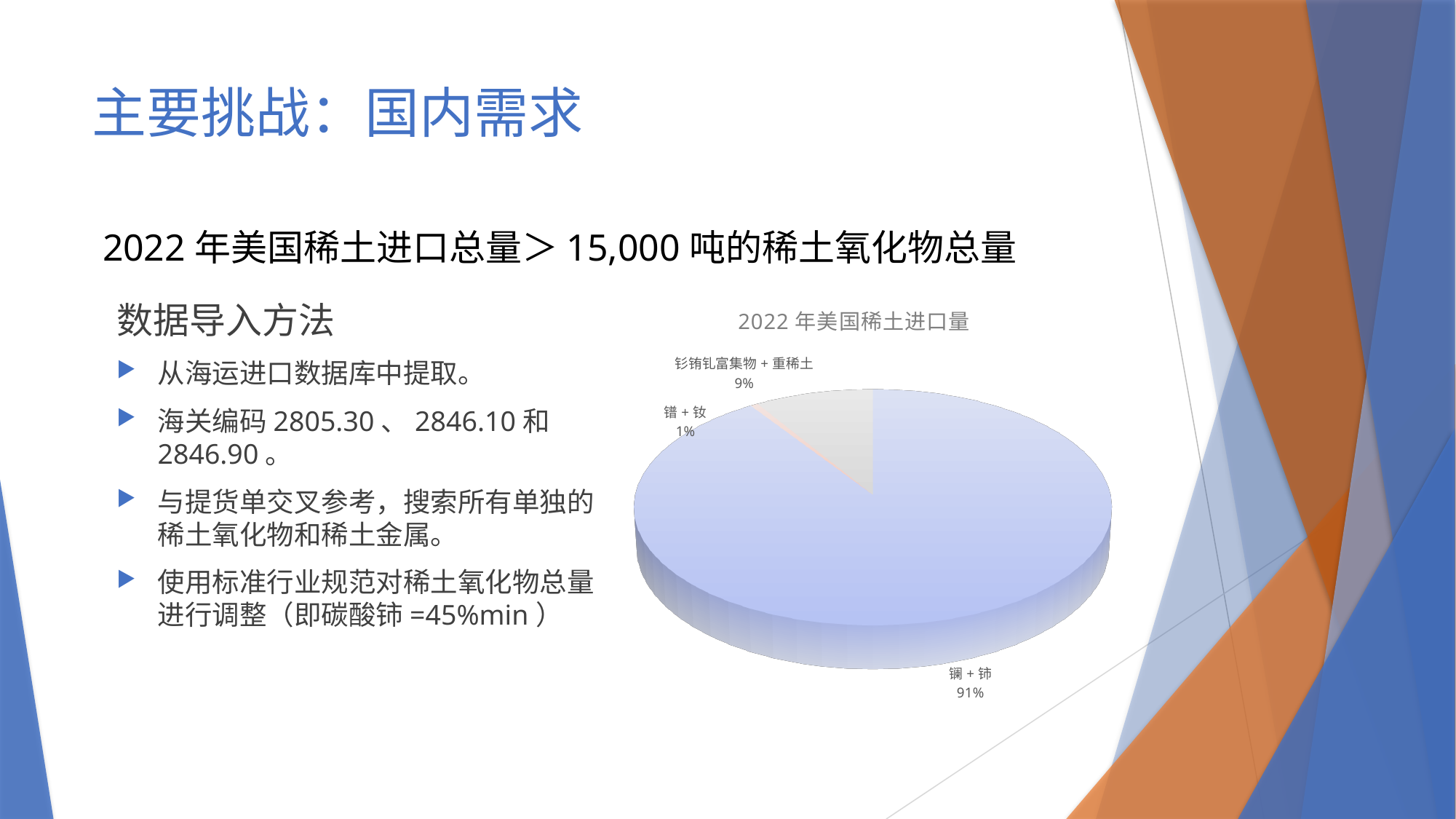
Which category has the largest share of the pie? 镧 + 铈 Which has a larger share, 钐铕钆富集物 + 重稀土 or 镨 + 钕? 钐铕钆富集物 + 重稀土 What share of the pie does 镨 + 钕 account for? 1% What share of the pie does 钐铕钆富集物 + 重稀土 account for? 9% What kind of chart is shown on the slide? pie chart What is the title of the chart? 2022 年美国稀土进口量 What is the difference in percentage points between the shares of 镧 + 铈 and 钐铕钆富集物 + 重稀土? 82 What share of the pie does 镧 + 铈 account for? 91% What is the difference in percentage points between the shares of 钐铕钆富集物 + 重稀土 and 镨 + 钕? 8 Is the share for 镧 + 铈 greater or less than 50%? greater How many slices does the pie chart have? 3 Which category has the smallest share of the pie? 镨 + 钕